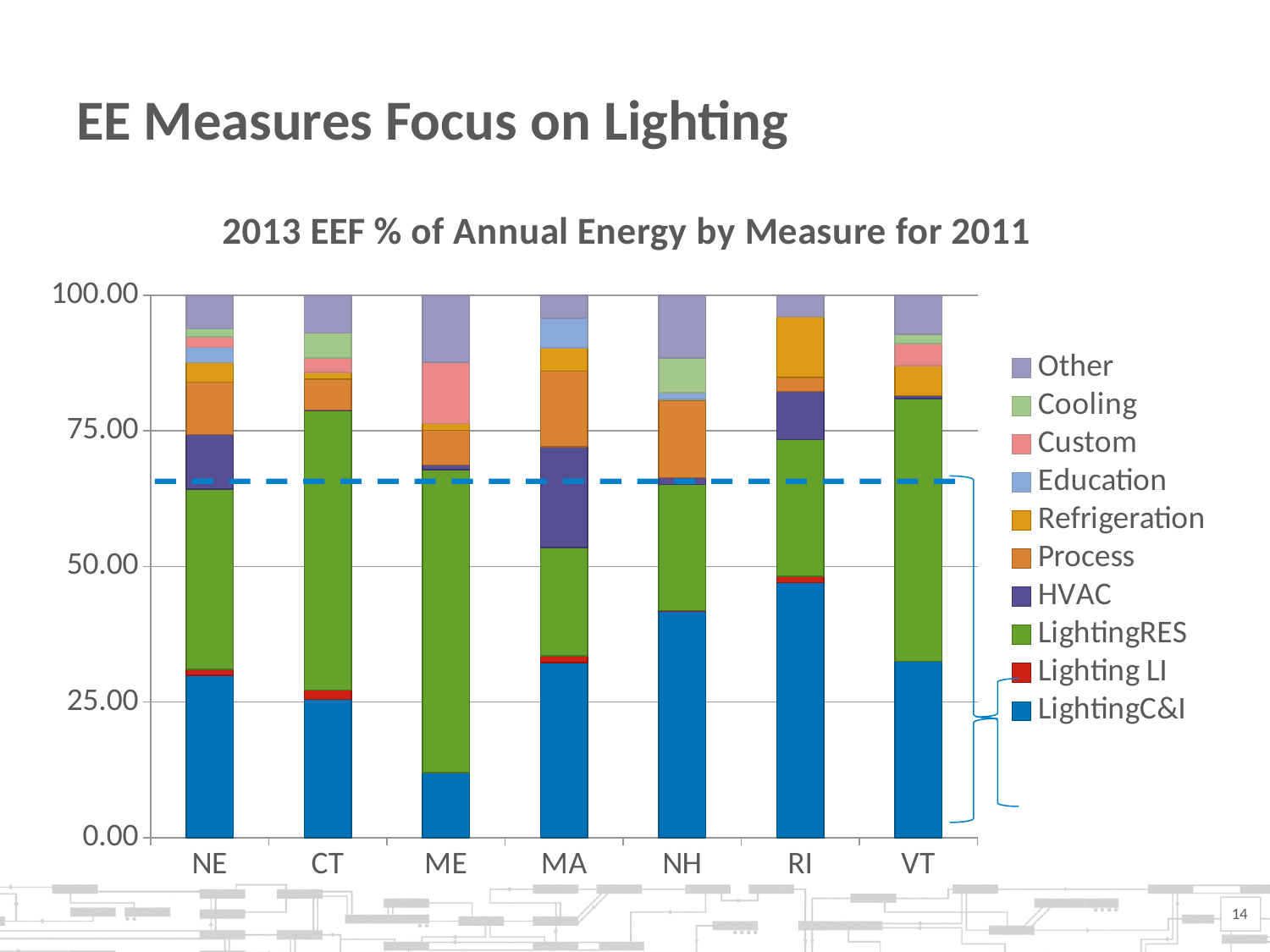
What is the total height of the stacked bar for NE? 100.00 Which is larger, the LightingC&I value for NE or for ME? NE Is the LightingC&I value for ME greater or less than 25.00? less Which category has the lowest LightingC&I value? ME Is the LightingC&I value for NE greater or less than 25.00? greater How many series does the chart's legend list? 10 What is the title of the chart? 2013 EEF % of Annual Energy by Measure for 2011 How many categories are shown on the x axis of the chart? 7 Is the LightingC&I value for RI greater or less than 50.00? less Which colour represents LightingC&I in the legend? Blue What kind of chart is shown on the slide? Stacked bar chart Which category has the highest LightingC&I value? RI